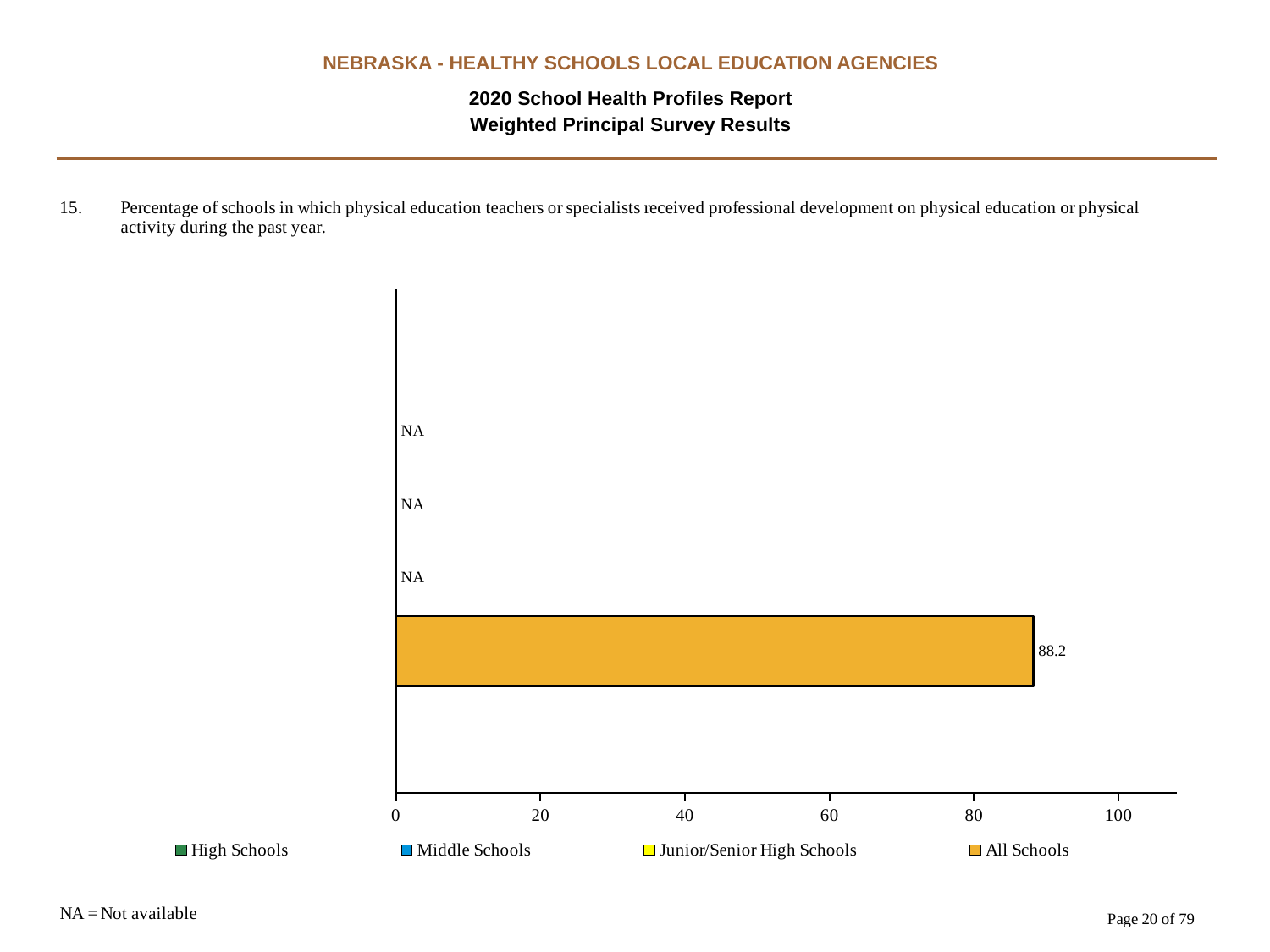
Which series is shown in orange in the legend? All Schools What does NA stand for according to the note on the slide? Not available How many series does the legend list? 4 What kind of chart is shown on the slide? bar chart What is the highest value shown on the x axis? 100 What is the value shown for All Schools? 88.2 Is the value for All Schools greater or less than 80? greater How many bars on the chart are labelled NA? 3 Is the value for All Schools greater or less than 100? less